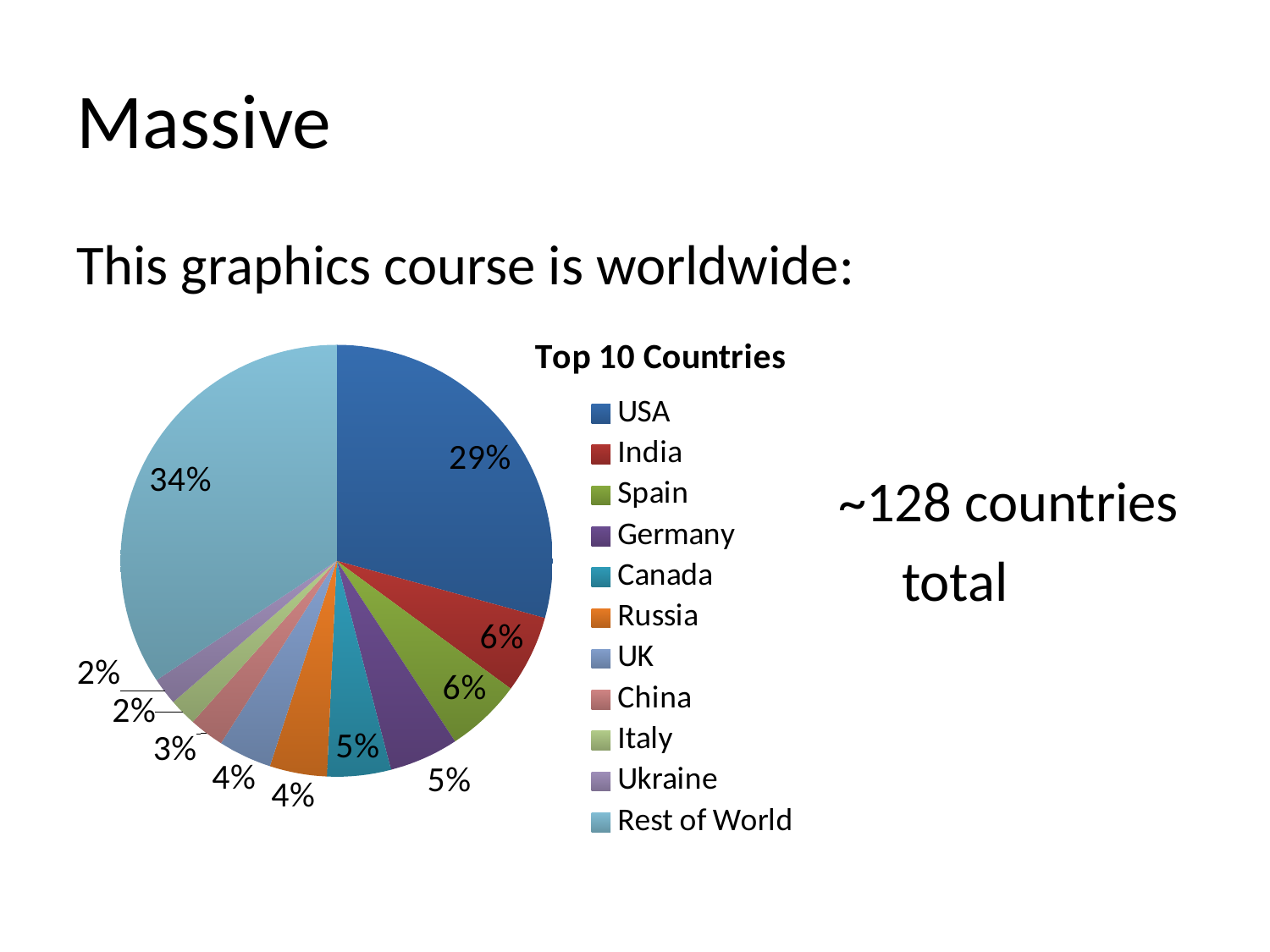
How many slices does the pie chart have? 11 What is the difference in percentage points between USA and Spain? 23 What is the chart's title? Top 10 Countries What is the difference in percentage points between Rest of World and USA? 5 Which slice of the pie is the largest? Rest of World What share of the pie does USA account for? 29% What is the value shown for China? 3% What is the value shown for Germany? 5% How many entries does the legend list? 11 What kind of chart is shown on the slide? pie chart What share of the pie does Rest of World account for? 34% Which is larger, the slice for USA or the slice for India? USA